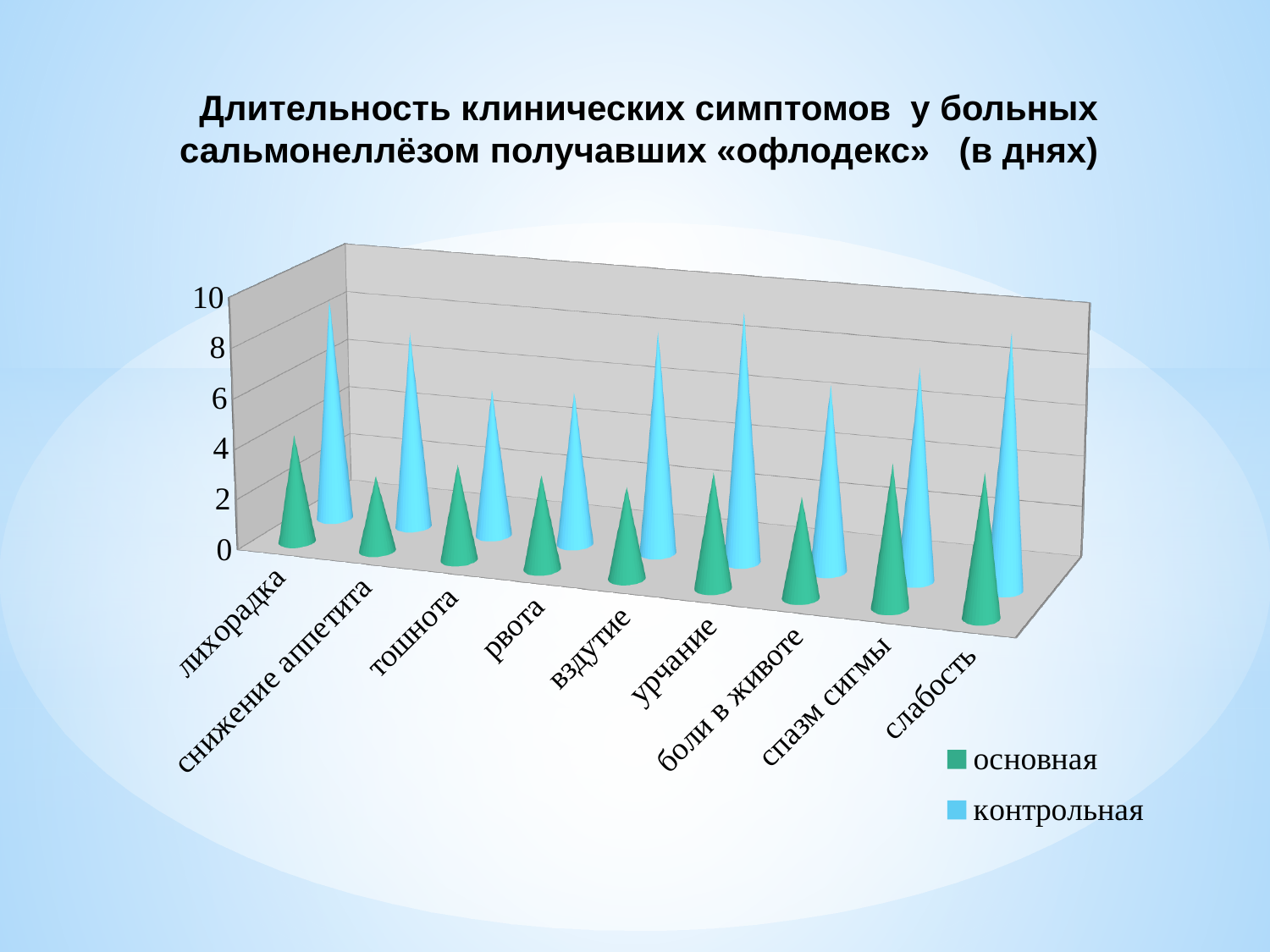
Is the 'контрольная' value for 'тошнота' greater or less than 4? greater For 'слабость', which series has the larger value, 'основная' or 'контрольная'? контрольная Which colour represents the 'основная' series in the chart? green How many symptom categories are shown on the x axis of the chart? 9 Is the 'основная' value for 'лихорадка' greater or less than 6? less What kind of chart is shown on the slide? bar chart Is the 'контрольная' value for 'урчание' greater or less than 6? greater How many series does the chart legend list? 2 What are the two series named in the legend? основная, контрольная For 'лихорадка', which series has the larger value, 'основная' or 'контрольная'? контрольная